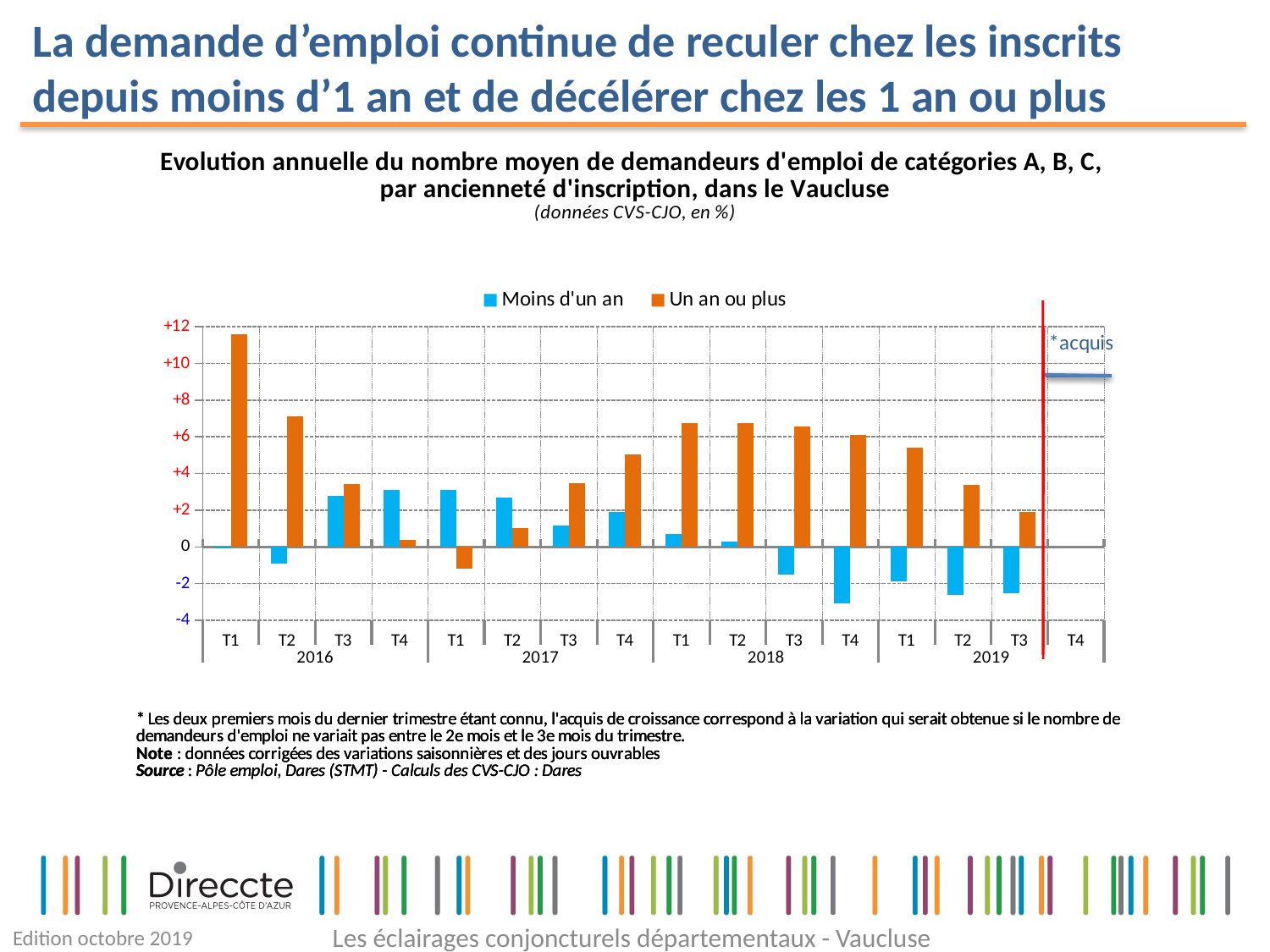
Is the value for 'Moins d'un an' in T4 2018 greater or less than -2? less What kind of chart is shown on the slide? bar chart How many years are labelled along the x axis? 4 Is the value for 'Un an ou plus' in T4 2017 greater or less than +4? greater Do the values for 'Un an ou plus' rise or fall from T1 2016 to T4 2016? fall Which quarter has the highest value for the 'Un an ou plus' series? T1 2016 In T1 2017, which series has the larger value, 'Moins d'un an' or 'Un an ou plus'? Moins d'un an Which quarter has the lowest value for the 'Moins d'un an' series? T4 2018 Is the value for 'Un an ou plus' in T1 2016 greater or less than +10? greater Which colour represents the 'Moins d'un an' series in the legend? blue Which quarter has the lowest value for the 'Un an ou plus' series? T1 2017 How many series does the legend list? 2